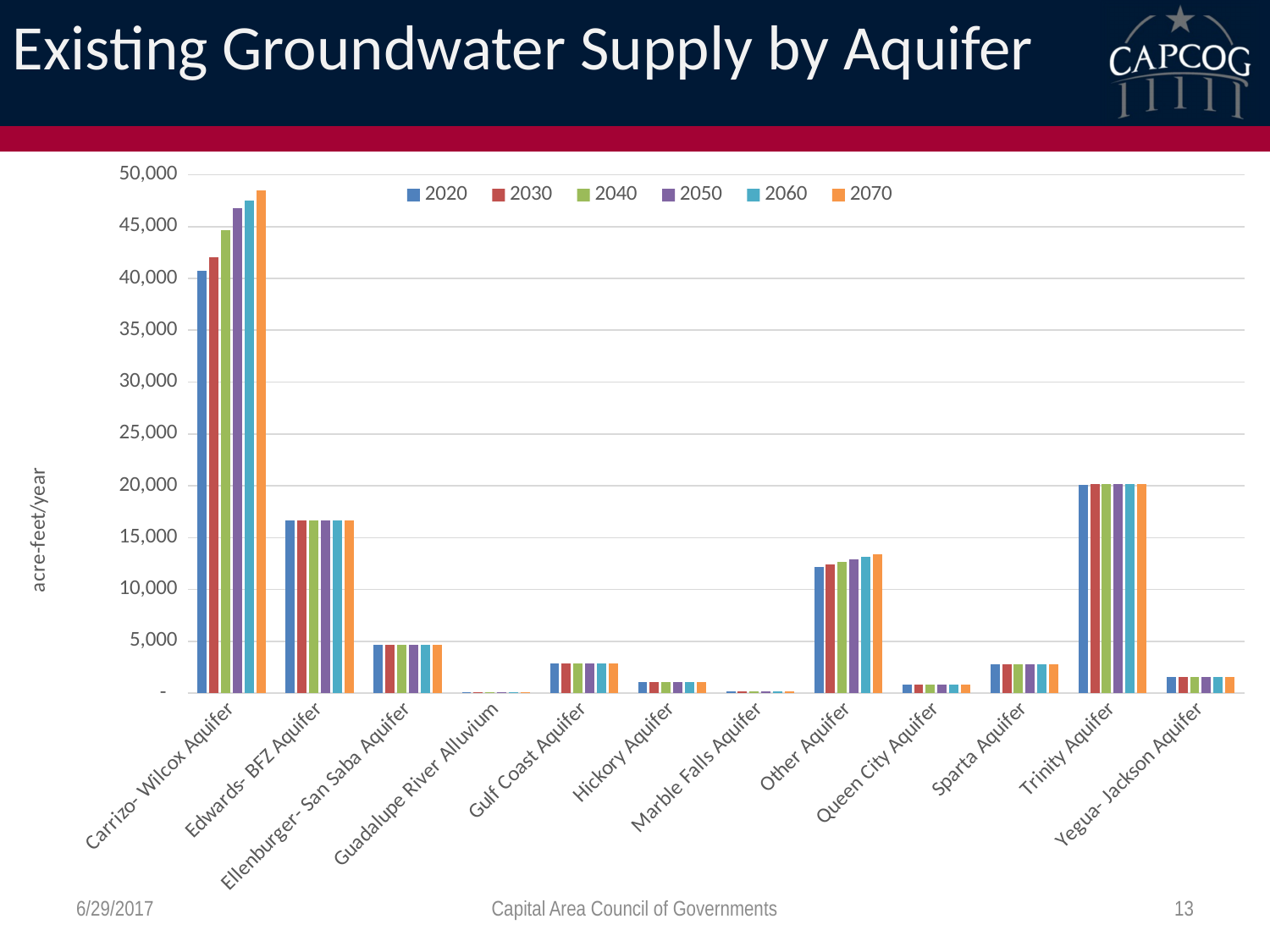
Is the 2020 value for the Carrizo- Wilcox Aquifer greater or less than 35,000? greater Is the 2070 value for the Trinity Aquifer greater or less than 25,000? less Is the 2070 value for the Other Aquifer greater or less than 10,000? greater Which aquifer has the highest groundwater supply? Carrizo- Wilcox Aquifer What unit is shown on the y axis label? acre-feet/year Which is larger in 2020, the Trinity Aquifer or the Edwards- BFZ Aquifer? Trinity Aquifer Do the values for the Carrizo- Wilcox Aquifer rise or fall from 2020 to 2070? rise How many series does the legend list? 6 What kind of chart is shown on the slide? bar chart How many aquifer categories are shown on the x axis? 12